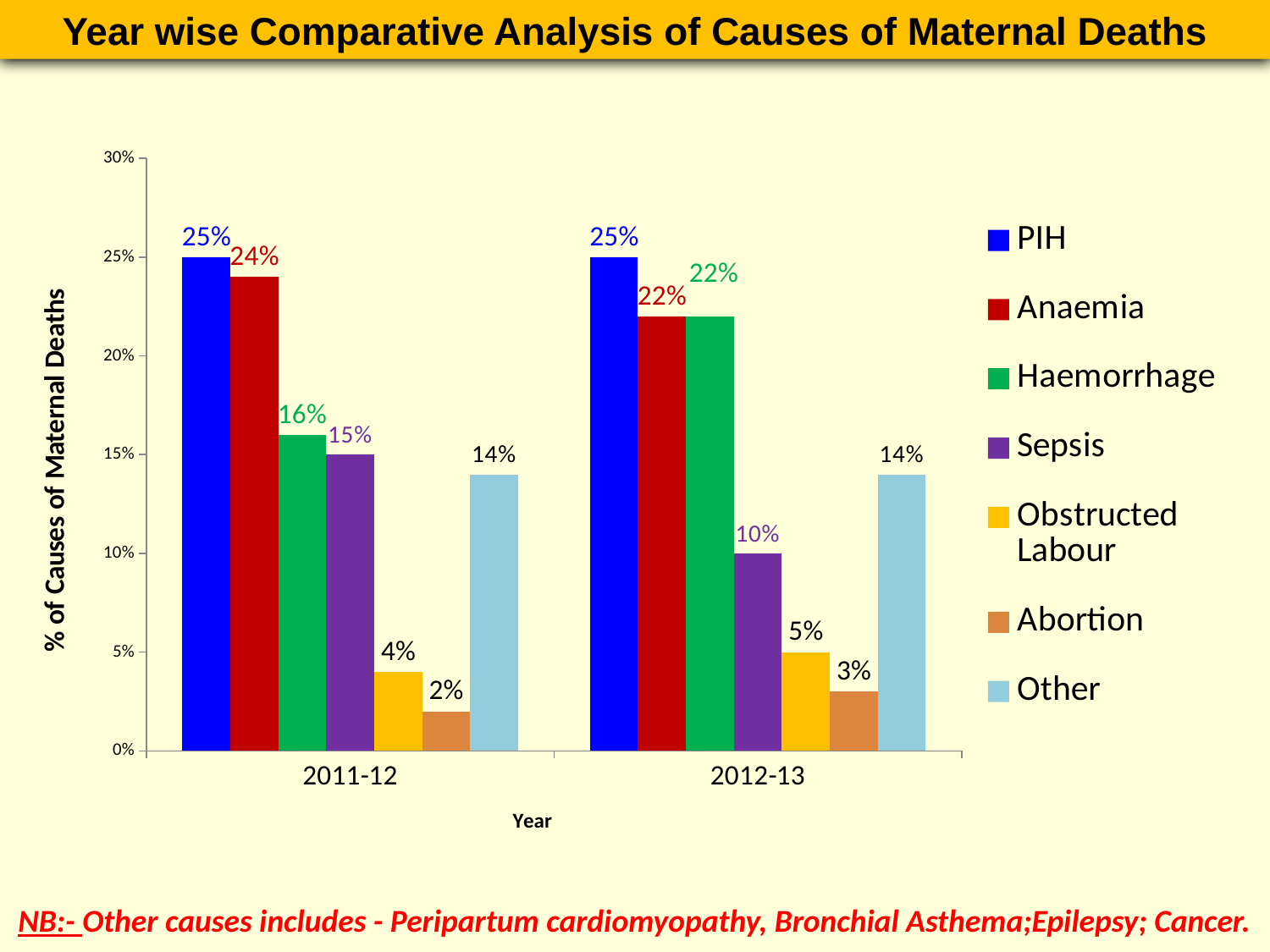
What is the difference between the Haemorrhage values for 2012-13 and 2011-12? 6% What is the value for Sepsis in 2012-13? 10% What kind of chart is shown on the slide? Bar chart What is the label of the y axis? % of Causes of Maternal Deaths What is the value for Abortion in 2011-12? 2% Which cause has the lowest value in 2011-12? Abortion What is the value for Haemorrhage in 2012-13? 22% Which cause has the highest value in 2012-13? PIH What is the value for Anaemia in 2011-12? 24% How many year categories are shown on the x axis? 2 How many series does the legend list? 7 Which is larger, Sepsis in 2011-12 or Sepsis in 2012-13? Sepsis in 2011-12